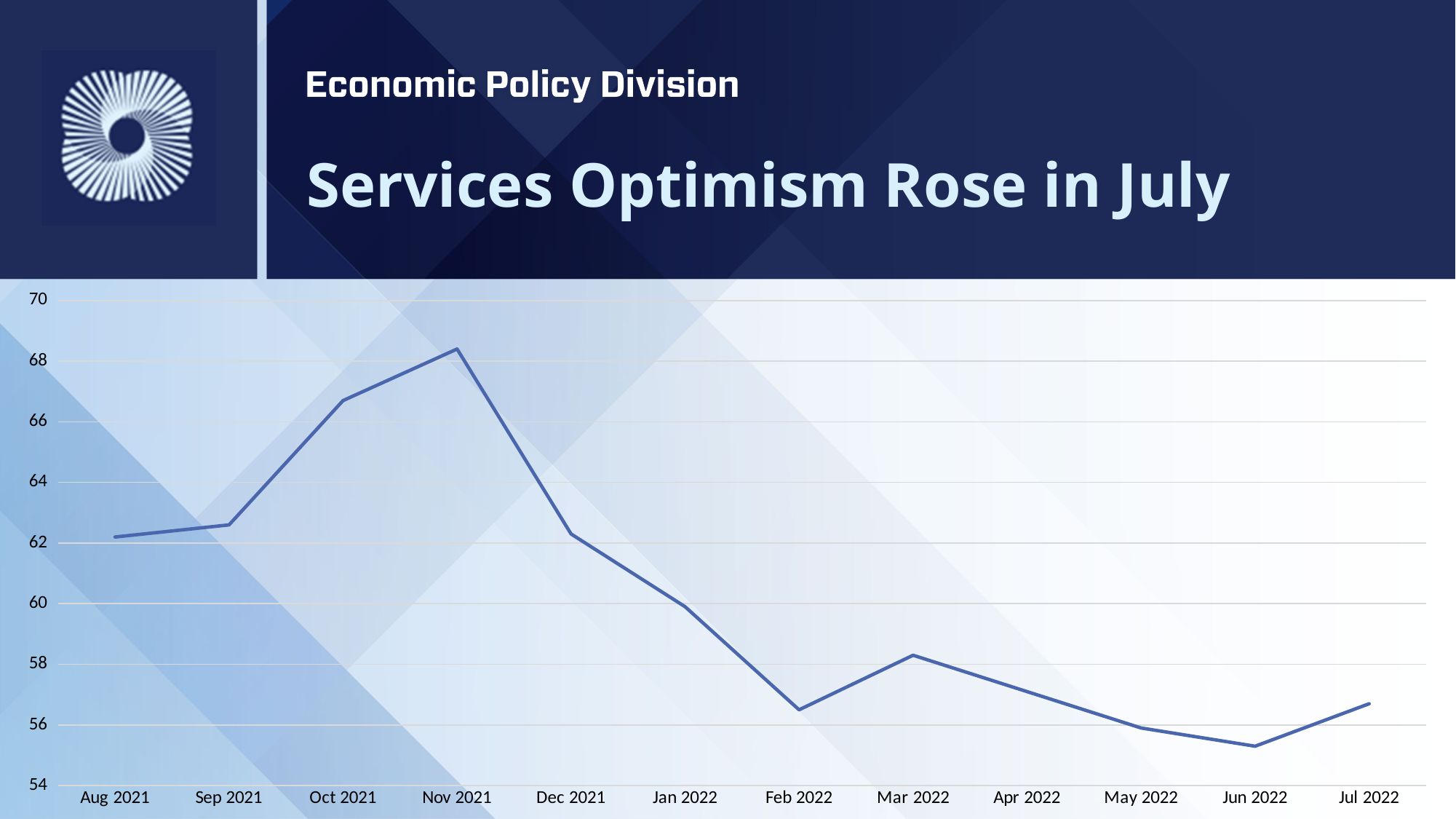
Which month has the lowest value? Jun 2022 Is the value for Feb 2022 greater or less than 58? less How many months are plotted along the x axis? 12 Which month has the highest value? Nov 2021 Is the value for Jun 2022 greater or less than 56? less Which is larger, the value for Jul 2022 or the value for Jun 2022? Jul 2022 What kind of chart is shown on the slide? line chart Is the value for Oct 2021 greater or less than 66? greater What is the title of the slide containing the chart? Services Optimism Rose in July Do the values rise or fall from Nov 2021 to Feb 2022? fall Which is larger, the value for Nov 2021 or the value for Dec 2021? Nov 2021